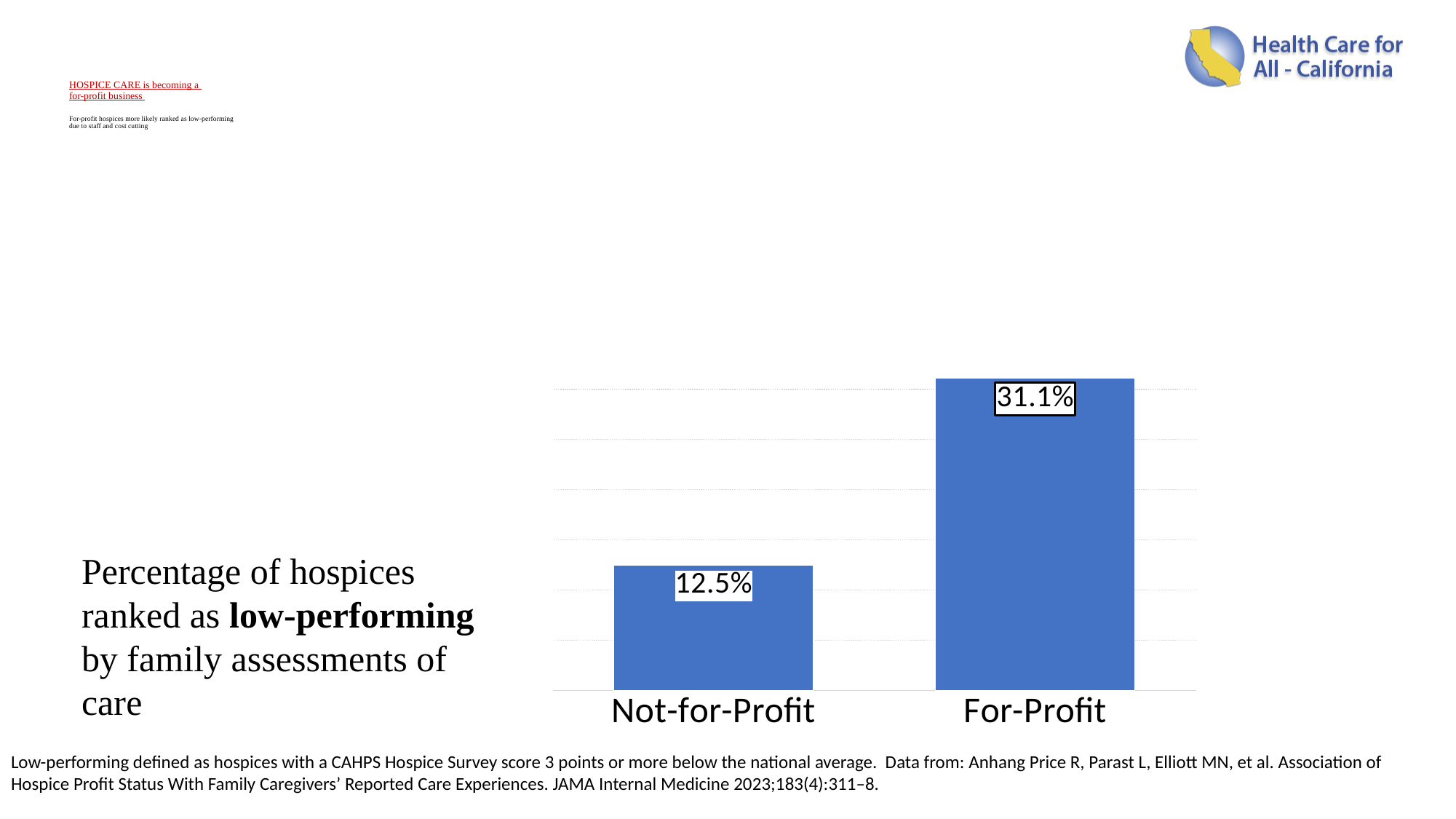
Do the values rise or fall moving from Not-for-Profit to For-Profit along the x axis? rise Which category has the higher percentage of hospices ranked as low-performing? For-Profit What does the chart measure, according to the text to its left? Percentage of hospices ranked as low-performing by family assessments of care What percentage of Not-for-Profit hospices are ranked as low-performing? 12.5% What is the difference in percentage points between the For-Profit and Not-for-Profit bars? 18.6 Is the value for For-Profit larger or smaller than the value for Not-for-Profit? larger Which category has the lower percentage of hospices ranked as low-performing? Not-for-Profit What kind of chart is shown on the slide? bar chart What colour are the bars in the chart? blue What percentage of For-Profit hospices are ranked as low-performing? 31.1% How many categories are shown in the chart? 2